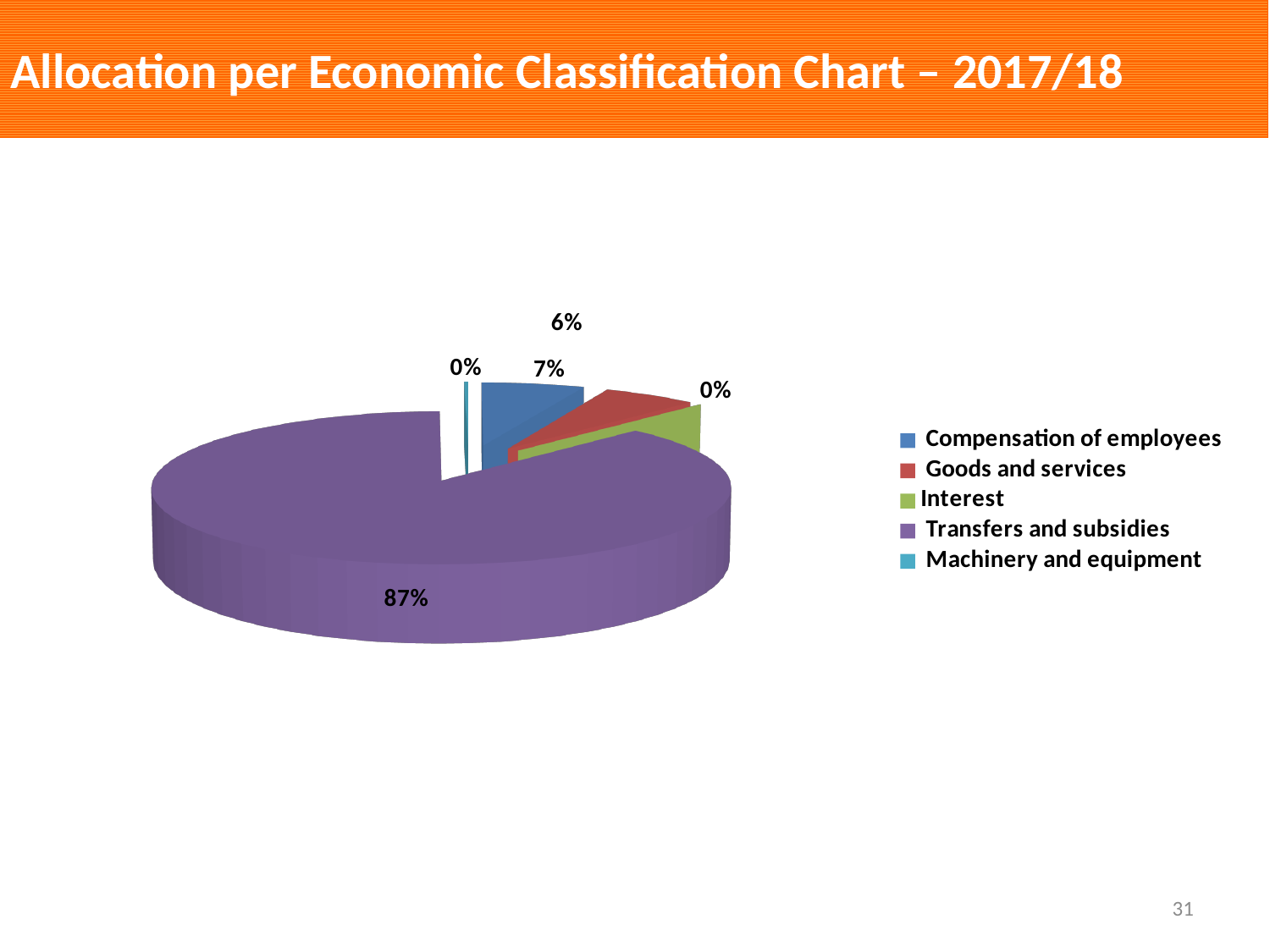
What share of the pie is Transfers and subsidies? 87% How many categories does the legend list? 5 What percentage is shown for Interest? 0% How many slices are labelled 0%? 2 What kind of chart is shown on the slide? pie chart Which is larger, Transfers and subsidies or Compensation of employees? Transfers and subsidies What is the title of the chart on the slide? Allocation per Economic Classification Chart – 2017/18 What is the difference between the Transfers and subsidies share and the Interest share? 87% Which is larger, Compensation of employees or Interest? Compensation of employees What percentage is shown for Machinery and equipment? 0% Which category has the largest slice of the pie? Transfers and subsidies What colour is the slice for Transfers and subsidies? purple